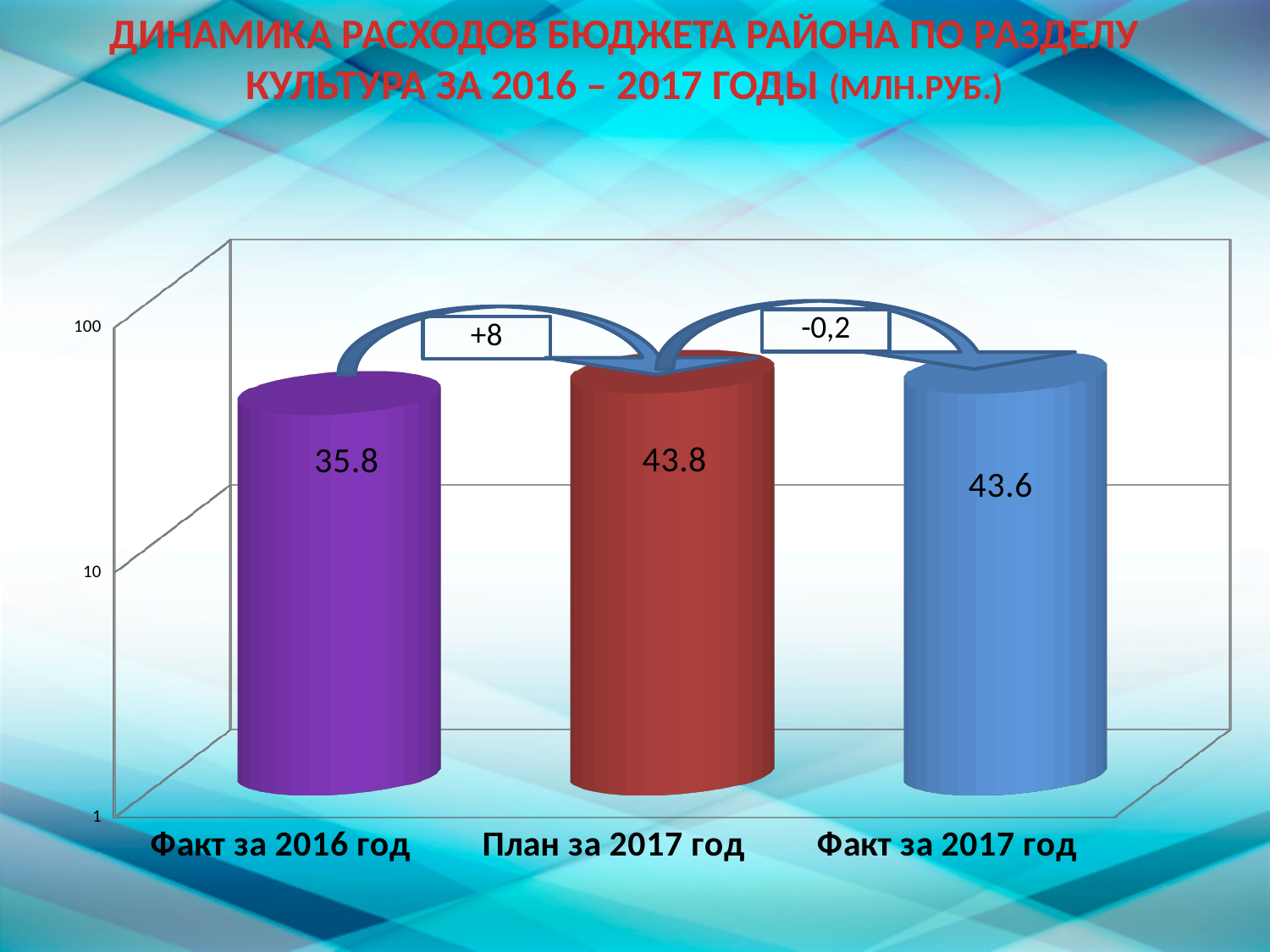
How many categories are shown on the x axis? 3 What is the value for Факт за 2017 год? 43.6 Which is larger, the value for Факт за 2016 год or the value for План за 2017 год? План за 2017 год What is the value for План за 2017 год? 43.8 What is the difference between the values for План за 2017 год and Факт за 2017 год? 0.2 Which category has the highest value? План за 2017 год Is the value for Факт за 2016 год greater or less than 10? greater Which category has the lowest value? Факт за 2016 год What is the difference between the values for План за 2017 год and Факт за 2016 год? 8 What kind of chart is shown on the slide? bar chart What change is written in the annotation box between the first and second bars? +8 What is the value for Факт за 2016 год? 35.8